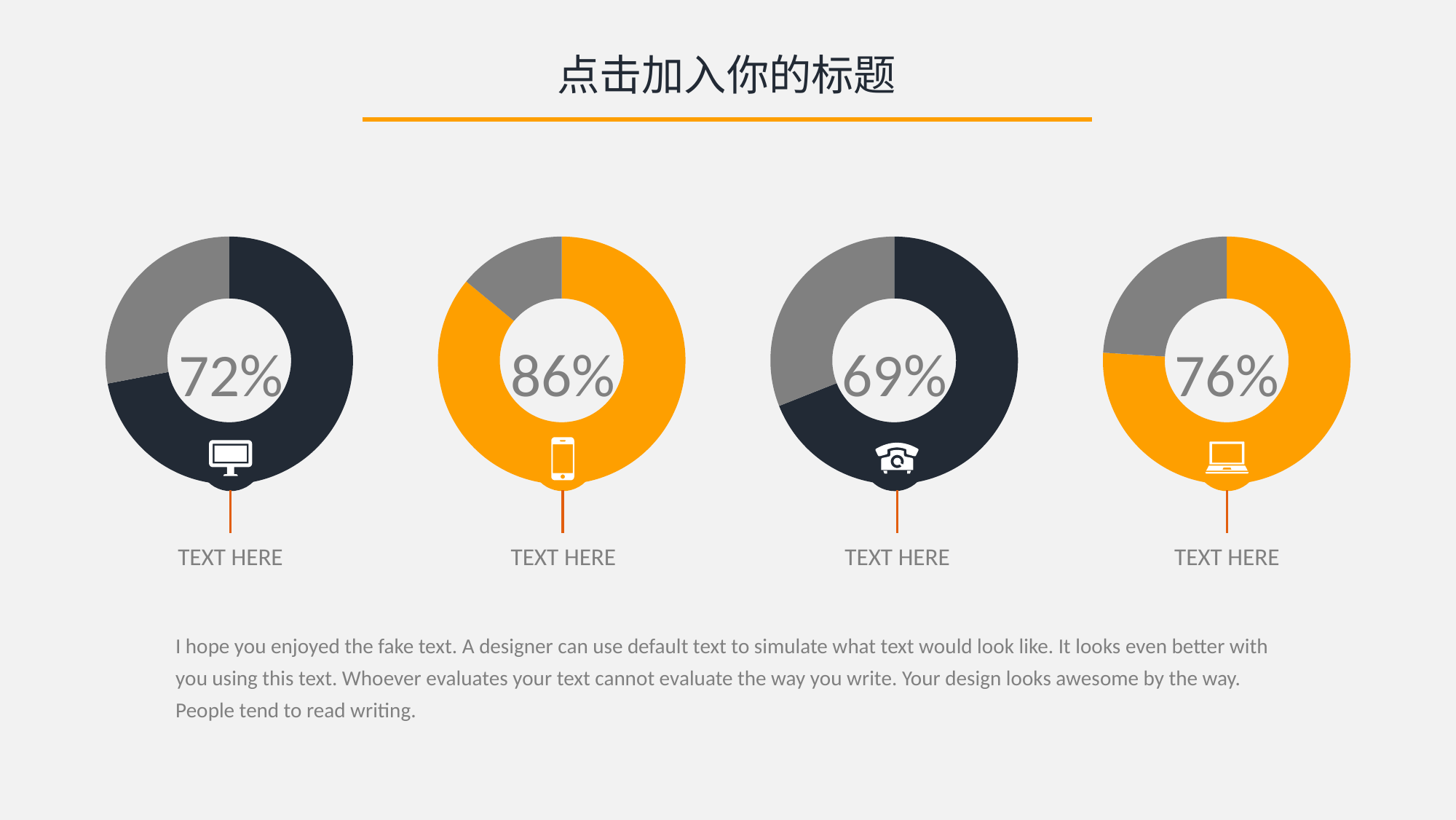
Which donut chart shows the lowest percentage? The third from the left (69%) What kind of chart is used for each of the four figures on the slide? Donut chart What value is shown in the centre of the rightmost donut chart? 76% Which is larger, the percentage in the leftmost donut chart or the percentage in the rightmost donut chart? The rightmost (76%) What value is shown in the centre of the second donut chart from the left? 86% What is the difference between the percentage in the second donut chart and the percentage in the third donut chart? 17% What value is shown in the centre of the third donut chart from the left? 69% How many donut charts are on the slide? 4 What is the difference between the percentage in the rightmost donut chart and the percentage in the leftmost donut chart? 4% What value is shown in the centre of the leftmost donut chart? 72% What colour is the filled portion of the second donut chart from the left? Orange Which donut chart shows the highest percentage? The second from the left (86%)